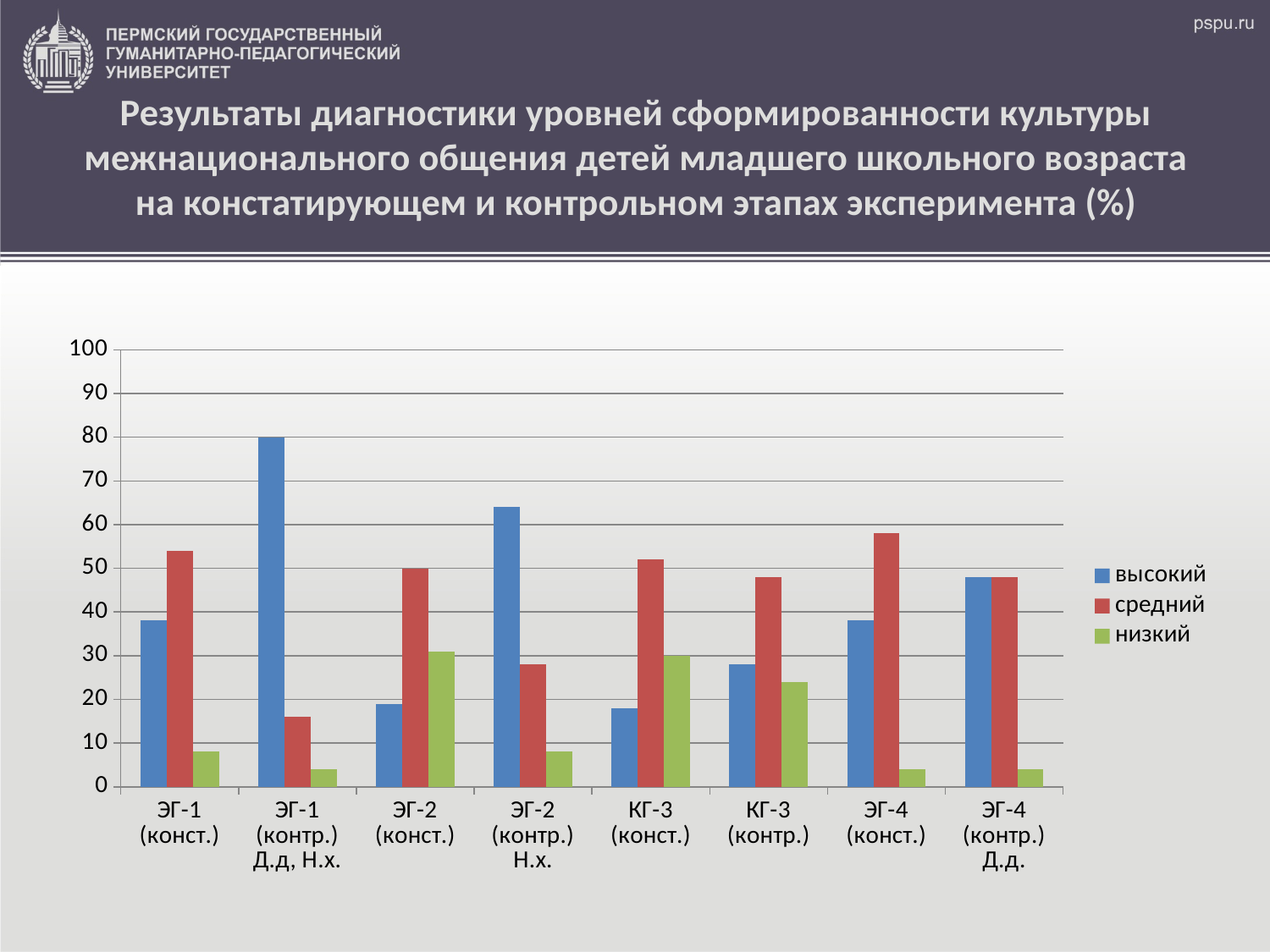
Is the высокий value for ЭГ-1 (конст.) greater or less than 40? less Which category has the highest value in the высокий series? ЭГ-1 (контр.) Д.д, Н.х. For ЭГ-2 (контр.) Н.х., which is larger: the высокий value or the средний value? высокий How many categories are shown along the x axis? 8 What is the value of the низкий series for КГ-3 (конст.)? 30 How many series does the legend list? 3 What is the value of the средний series for ЭГ-2 (конст.)? 50 Which category has the highest value in the средний series? ЭГ-4 (конст.) What is the value of the высокий series for ЭГ-1 (контр.) Д.д, Н.х.? 80 Which colour represents the высокий series in the legend? blue What kind of chart is shown on the slide? bar chart Is the низкий value for КГ-3 (контр.) greater or less than 30? less